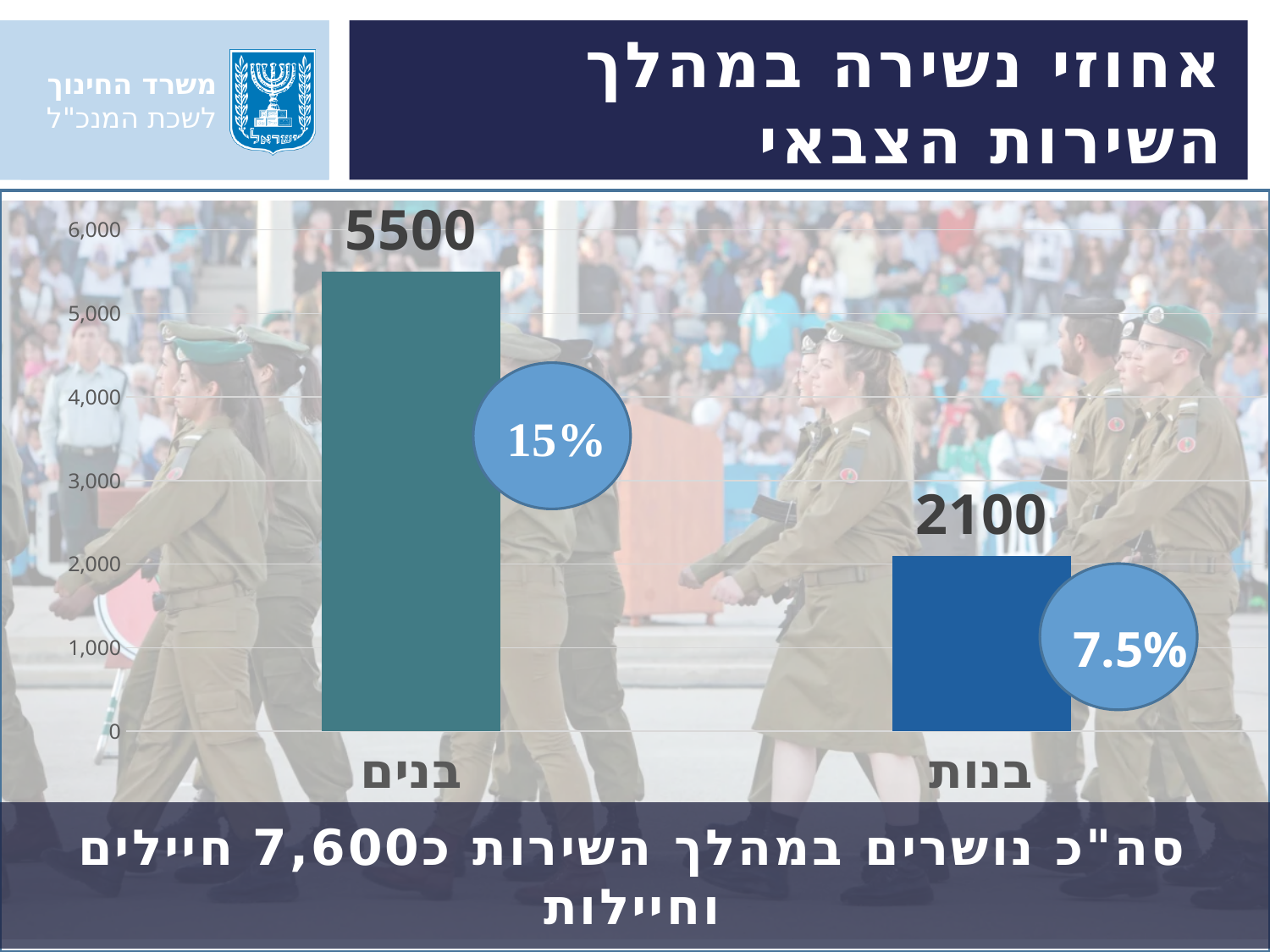
What is the difference between the values for בנים and בנות? 3400 Which category has the lowest value in the chart? בנות What is the value for בנות (girls) in the chart? 2100 Which is larger, the value for בנים or the value for בנות? בנים What percentage is shown in the circle next to the בנים bar? 15% What percentage is shown in the circle next to the בנות bar? 7.5% What kind of chart is shown on the slide? bar chart Is the value for בנות greater or less than 3,000? less How many categories are shown in the chart? 2 What is the value for בנים (boys) in the chart? 5500 Is the value for בנים greater or less than 5,000? greater Which category has the highest value in the chart? בנים